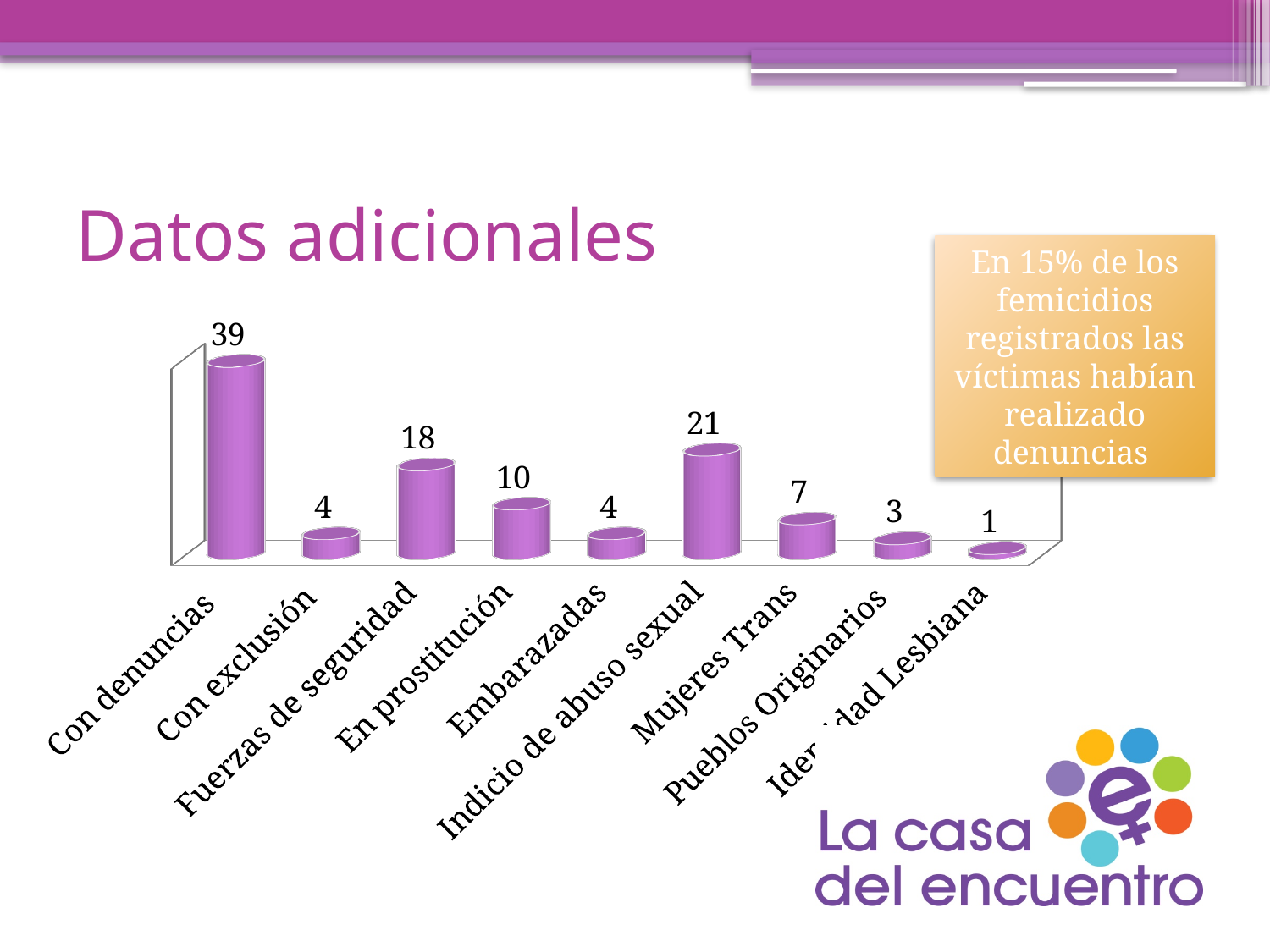
What is the lowest value shown in the chart? 1 What is the difference between the values for Con denuncias and Indicio de abuso sexual? 18 What is the value for Indicio de abuso sexual? 21 Which category has the highest value? Con denuncias What is the title of the slide containing the chart? Datos adicionales What is the value for Mujeres Trans? 7 What is the value for Con denuncias? 39 What kind of chart is shown on the slide? Bar chart What is the value for Fuerzas de seguridad? 18 What is the value for Pueblos Originarios? 3 Which is larger, the value for En prostitución or the value for Mujeres Trans? En prostitución How many categories are shown in the chart? 9